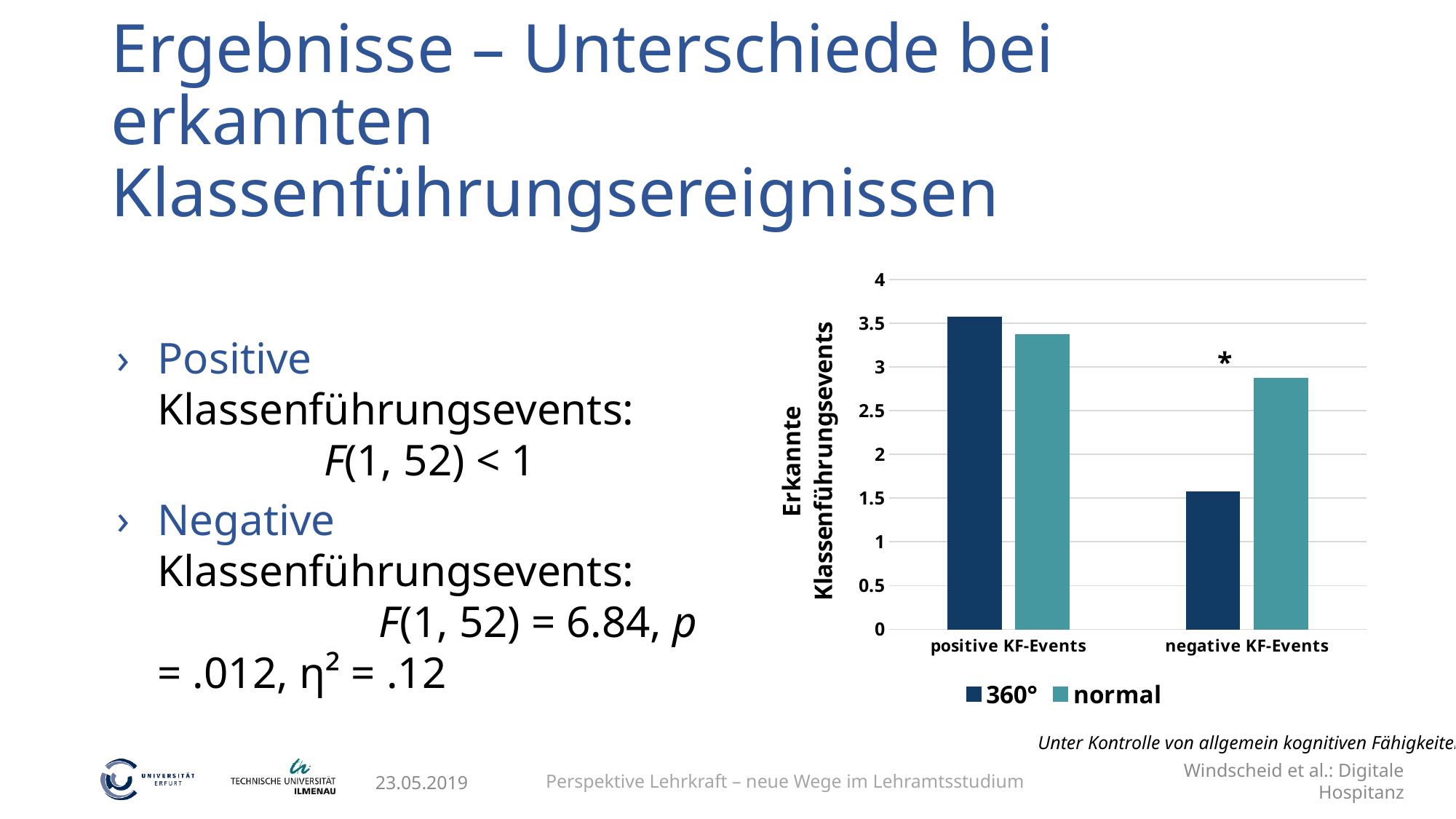
How many series does the chart legend list? 2 What are the two series named in the chart legend? 360° and normal For negative KF-Events, which series has the larger value, 360° or normal? normal What kind of chart is shown on the slide? bar chart Which bar in the chart is the lowest? 360° for negative KF-Events Is the value for normal at positive KF-Events greater or less than 3.5? less Is the value for normal at negative KF-Events greater or less than 2.5? greater How many categories are shown on the x axis of the chart? 2 Is the value for 360° at positive KF-Events greater or less than 3? greater What is the y-axis label of the chart? Erkannte Klassenführungsevents Does the 360° series rise or fall from positive KF-Events to negative KF-Events? fall